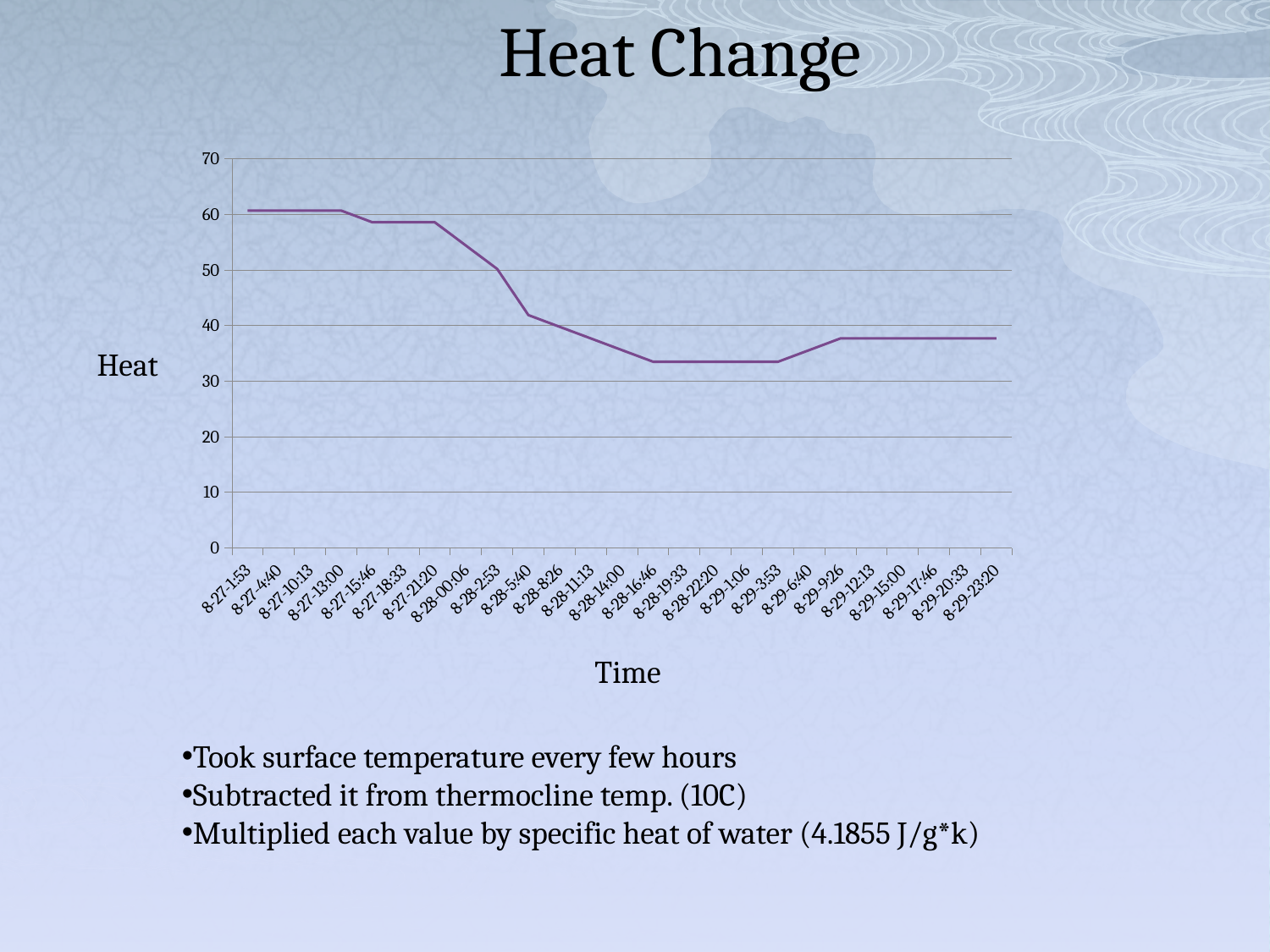
What is the title of the chart? Heat Change Is the value for 8-28-22:20 greater or less than 30? greater How many time points are plotted along the x axis? 25 What is the label on the x axis of the chart? Time Is the value for 8-29-23:20 greater or less than 50? less What kind of chart is shown on the slide? line chart Which has the larger value, 8-28-16:46 or 8-27-21:20? 8-27-21:20 Is the value for 8-27-1:53 greater or less than 50? greater Do the values generally rise or fall from the first time point to the last? fall Which has the larger value, 8-27-1:53 or 8-29-23:20? 8-27-1:53